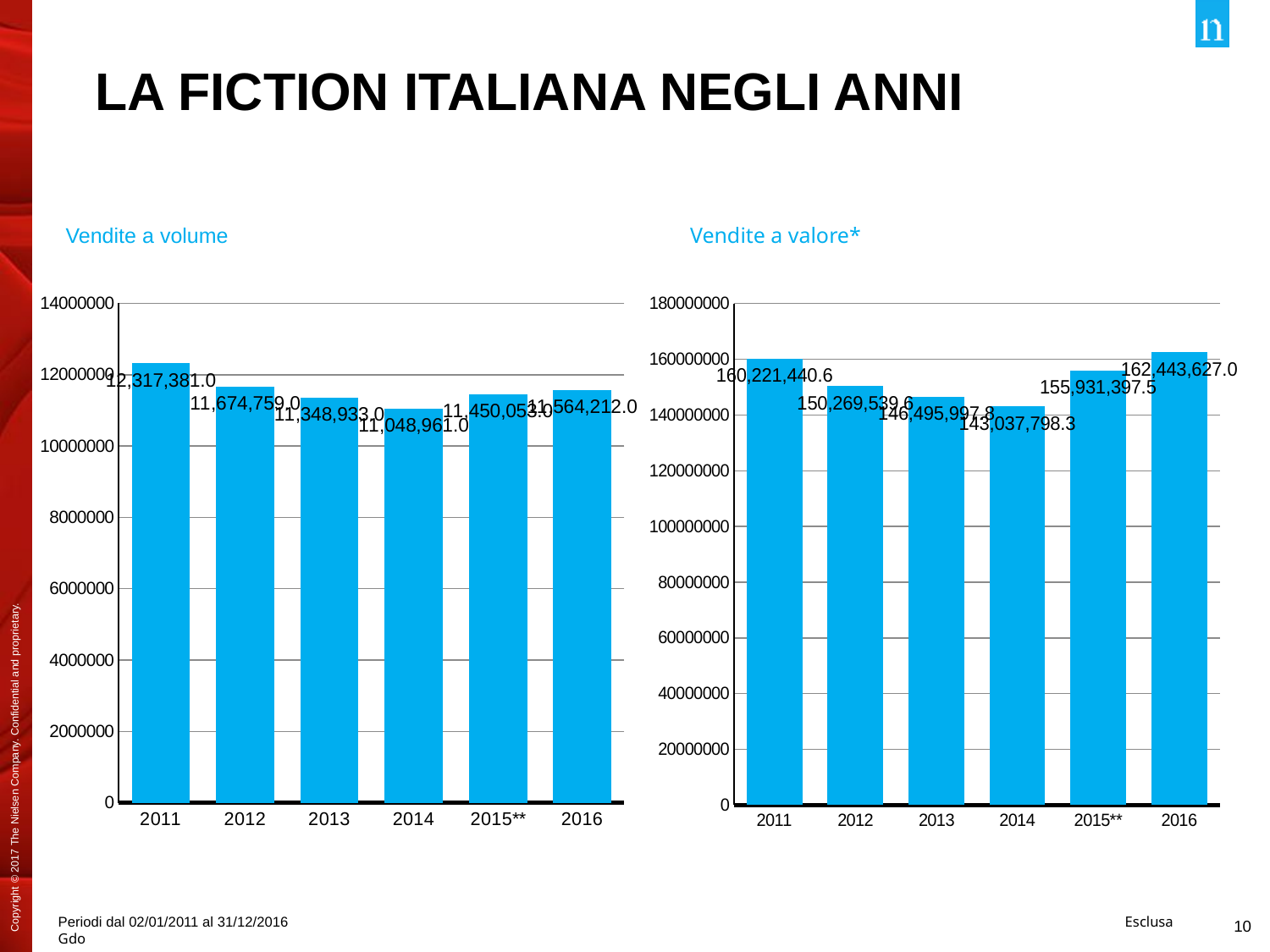
In the 'Vendite a valore*' chart, what is the difference between the 2015** and 2014 values? 12,893,599.2 In the 'Vendite a valore*' chart, what is the value for 2016? 162,443,627.0 In the 'Vendite a valore*' chart, which year has the lowest value? 2014 What kind of chart is the 'Vendite a volume' chart? bar chart In the 'Vendite a volume' chart, which year has the highest value? 2011 How many years are shown on the x axis of the 'Vendite a valore*' chart? 6 In the 'Vendite a volume' chart, what is the value for 2011? 12,317,381.0 In the 'Vendite a valore*' chart, which is larger, the value for 2011 or the value for 2015**? 2011 In the 'Vendite a volume' chart, what is the value for 2014? 11,048,961.0 In the 'Vendite a valore*' chart, what is the value for 2015**? 155,931,397.5 In the 'Vendite a volume' chart, is the value for 2014 greater or less than 12000000? less In the 'Vendite a volume' chart, what is the difference between the 2011 and 2012 values? 642,622.0